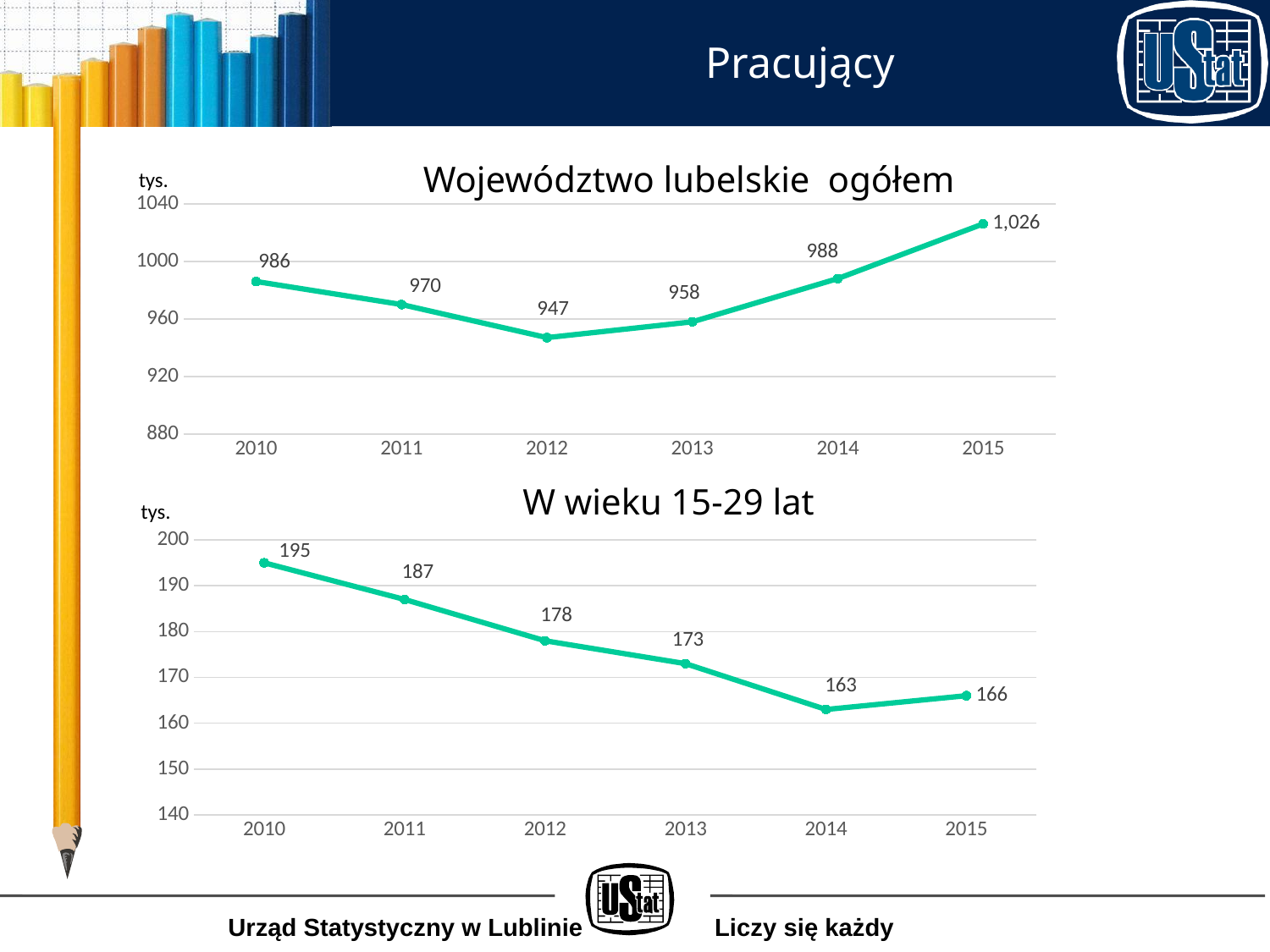
What type of chart is the 'Województwo lubelskie ogółem' chart? line chart In the 'W wieku 15-29 lat' chart, what is the value for 2013? 173 In the 'Województwo lubelskie ogółem' chart, what is the difference between the values for 2015 and 2014? 38 In the 'Województwo lubelskie ogółem' chart, how many data points are plotted? 6 In the 'Województwo lubelskie ogółem' chart, which year has the lowest value? 2012 In the 'Województwo lubelskie ogółem' chart, what is the value for 2012? 947 In the 'W wieku 15-29 lat' chart, which year has the lowest value? 2014 In the 'W wieku 15-29 lat' chart, what is the difference between the values for 2010 and 2015? 29 In the 'Województwo lubelskie ogółem' chart, which year has the highest value? 2015 What unit label is shown above the vertical axis of both charts? tys. In the 'W wieku 15-29 lat' chart, do the values generally rise or fall from 2010 to 2014? fall In the 'W wieku 15-29 lat' chart, is the value for 2011 larger or smaller than the value for 2012? larger